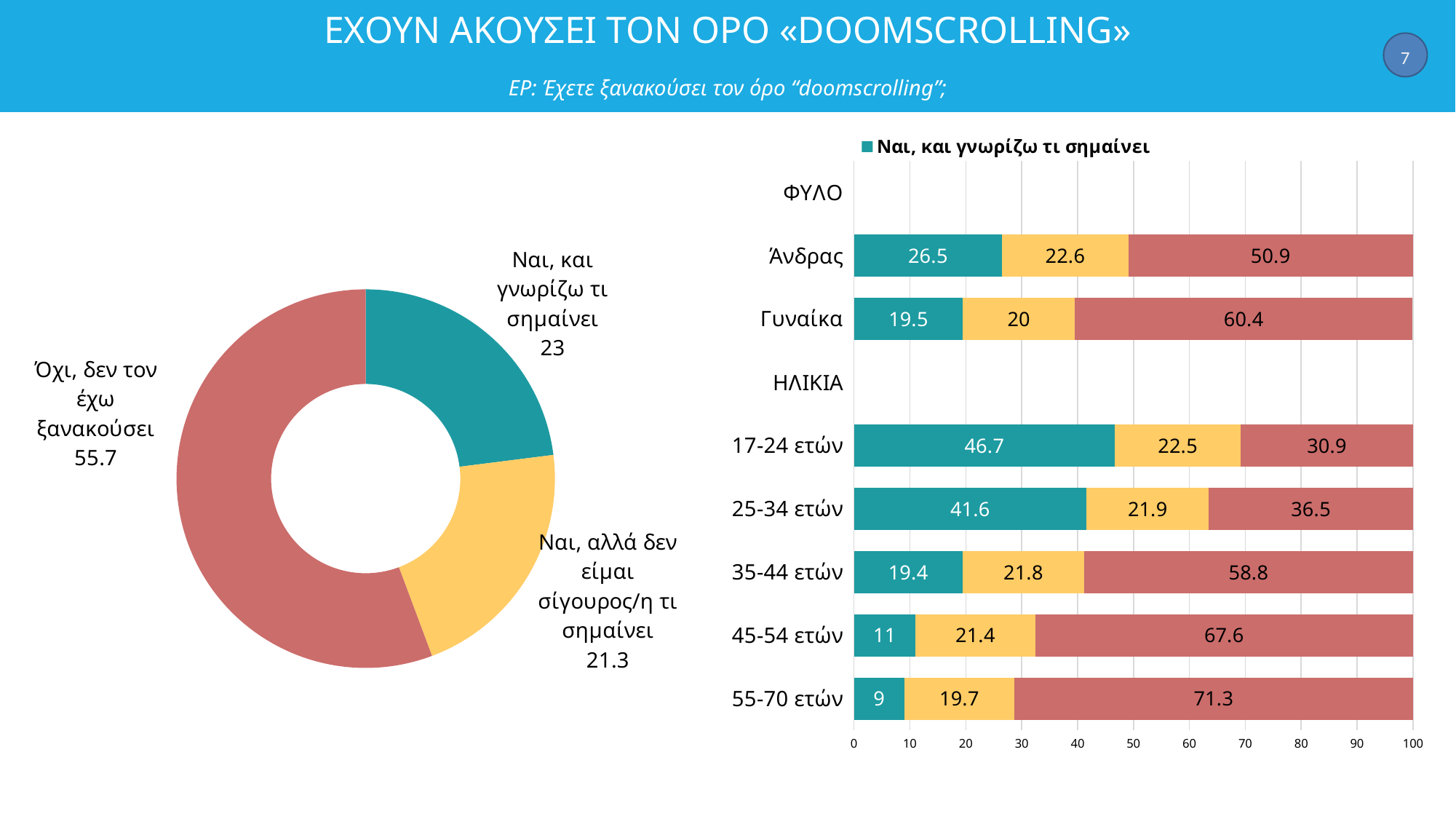
In the bar chart on the right, which has the larger red segment value: 45-54 ετών or 35-44 ετών? 45-54 ετών In the donut chart on the left, what is the value for "Όχι, δεν τον έχω ξανακούσει"? 55.7 In the bar chart on the right, what is the value of the red (rightmost) segment for Γυναίκα? 60.4 In the bar chart on the right, does the "Ναι, και γνωρίζω τι σημαίνει" value rise or fall as the age groups go from 17-24 ετών to 55-70 ετών? Fall How many bars (categories with data) are shown in the bar chart on the right? 7 In the bar chart on the right, which category has the highest value for "Ναι, και γνωρίζω τι σημαίνει"? 17-24 ετών In the bar chart on the right, which category has the lowest value for "Ναι, και γνωρίζω τι σημαίνει"? 55-70 ετών In the bar chart on the right, what is the value of "Ναι, και γνωρίζω τι σημαίνει" for 17-24 ετών? 46.7 In the bar chart on the right, what is the difference between the "Ναι, και γνωρίζω τι σημαίνει" values for Άνδρας and Γυναίκα? 7 In the donut chart on the left, which category has the smallest value? Ναι, αλλά δεν είμαι σίγουρος/η τι σημαίνει In the donut chart on the left, which category has the largest share? Όχι, δεν τον έχω ξανακούσει What kind of chart is the chart on the left of the slide? Donut (pie) chart